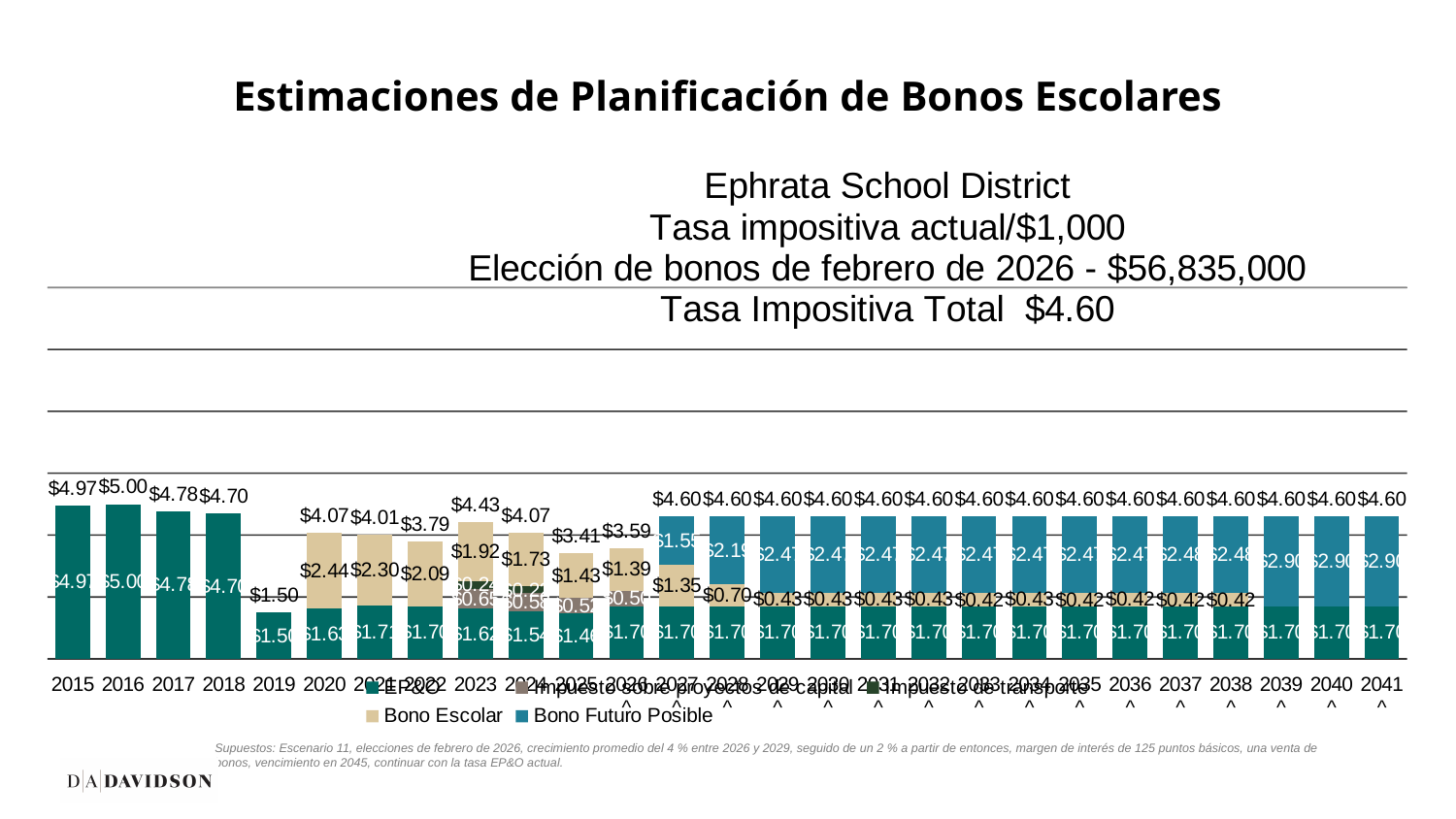
Which year has the highest total tax rate? 2016 Which is larger, the total tax rate for 2022 or for 2024? 2024 What is the total tax rate shown above the bar for 2016? $5.00 What is the total tax rate shown above the bar for 2023? $4.43 How many series does the legend list? 5 What type of chart is shown on the slide? stacked bar chart What total tax rate is shown for every year from 2027 to 2041? $4.60 How many years are shown on the x axis? 27 Which year has the lowest total tax rate? 2019 What is the total tax rate shown above the bar for 2019? $1.50 What is the Bono Escolar value for 2020? $2.44 What is the difference between the total tax rate in 2016 and in 2019? $3.50